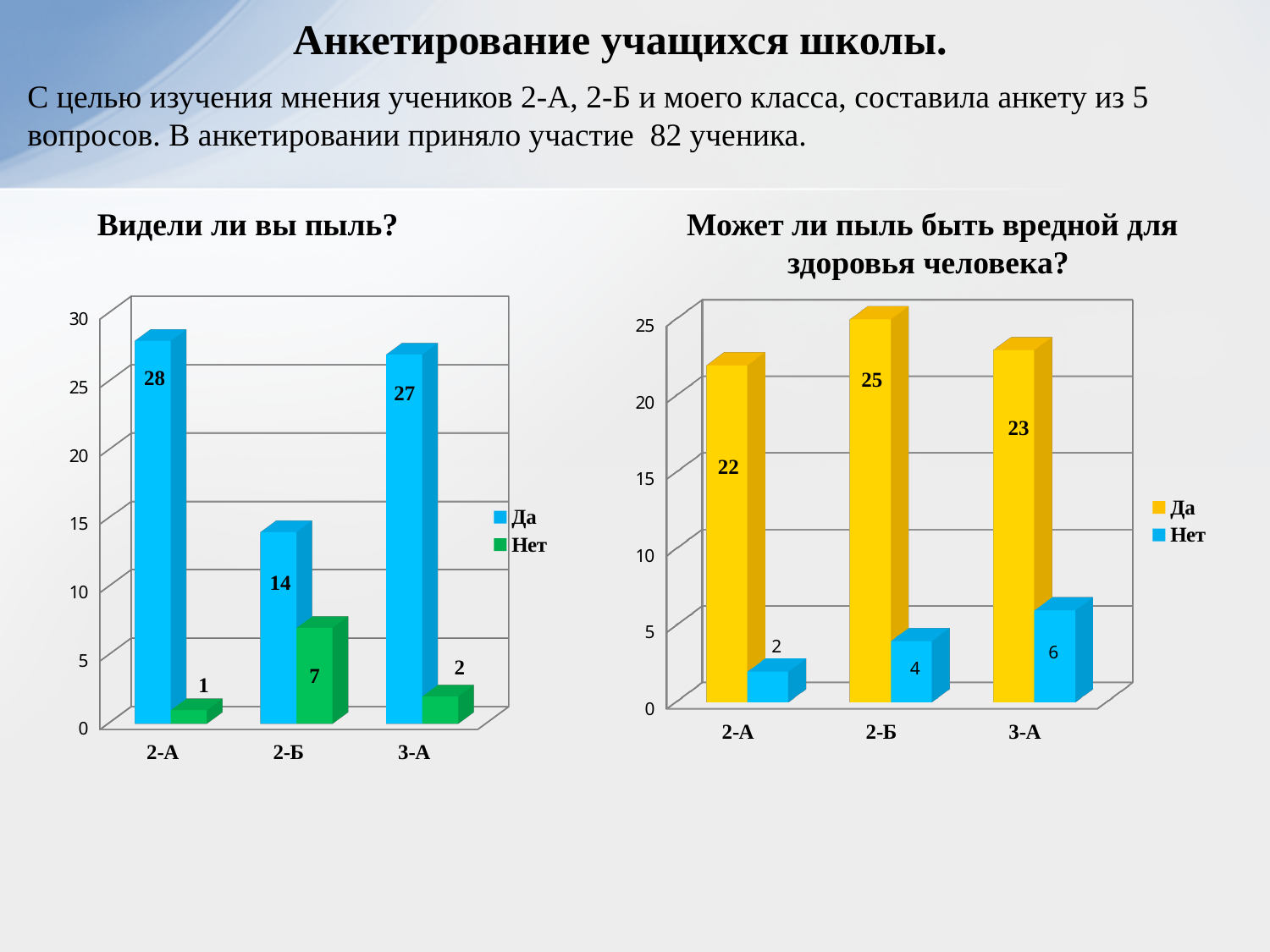
In the chart 'Видели ли вы пыль?', what is the difference between the 'Да' values for 2-А and 2-Б? 14 In the chart 'Может ли пыль быть вредной для здоровья человека?', what is the value for 'Нет' for 3-А? 6 In the chart 'Может ли пыль быть вредной для здоровья человека?', how many classes are shown on the x axis? 3 In the chart 'Видели ли вы пыль?', what is the value for 'Нет' for 2-Б? 7 In the chart 'Видели ли вы пыль?', which class has the lowest 'Да' value? 2-Б In the chart 'Может ли пыль быть вредной для здоровья человека?', which class has the highest 'Да' value? 2-Б What kind of chart is 'Может ли пыль быть вредной для здоровья человека?'? bar chart In the chart 'Видели ли вы пыль?', how many series does the legend list? 2 In the chart 'Видели ли вы пыль?', what is the value for 'Да' for 2-А? 28 In the chart 'Видели ли вы пыль?', is the 'Да' value for 3-А greater or less than 25? greater In the chart 'Может ли пыль быть вредной для здоровья человека?', which is larger: the 'Нет' value for 2-А or for 2-Б? 2-Б In the chart 'Может ли пыль быть вредной для здоровья человека?', what is the value for 'Да' for 2-Б? 25